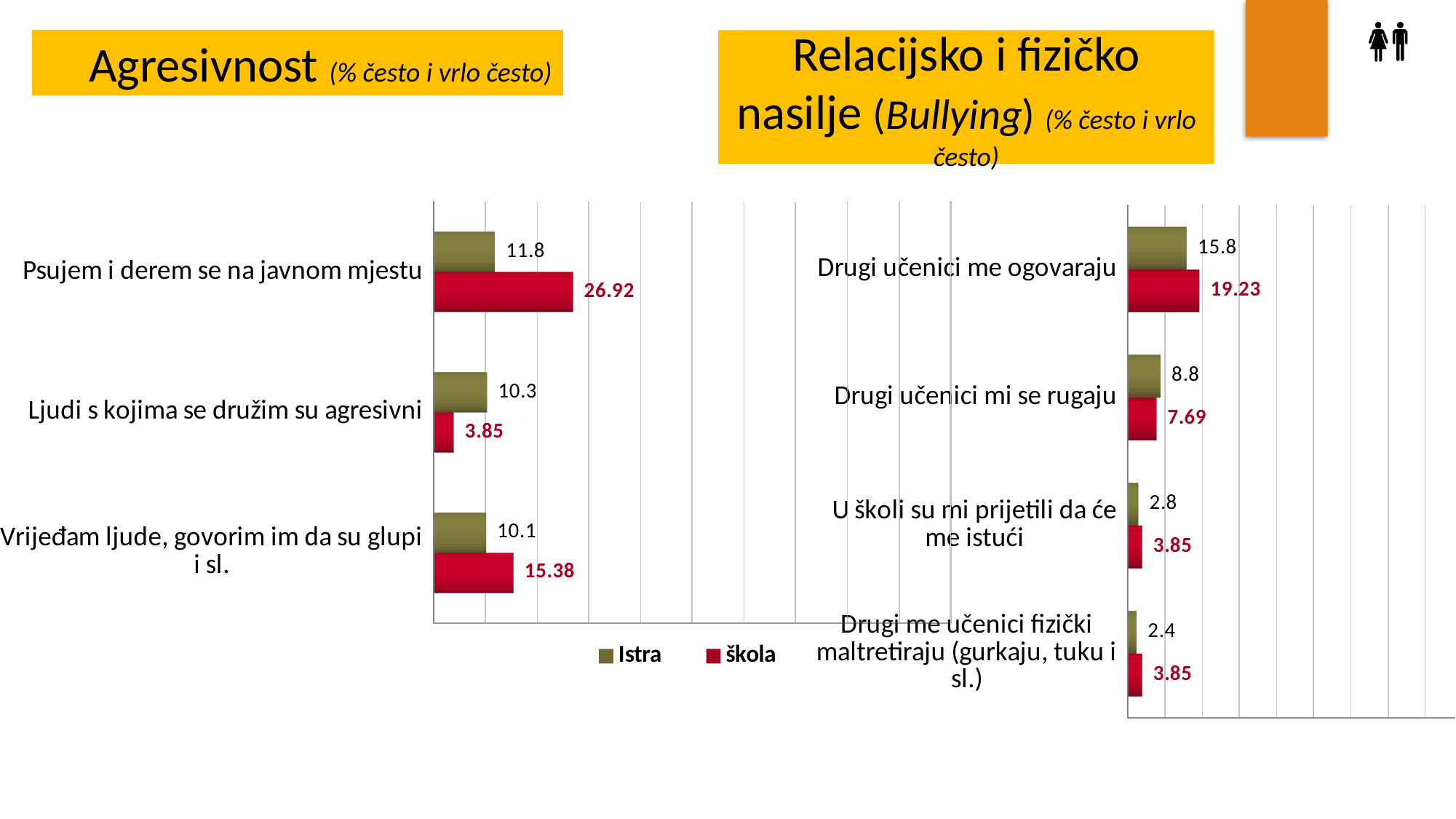
In the Relacijsko i fizičko nasilje (Bullying) chart, what is the škola value for 'Drugi učenici me ogovaraju'? 19.23 In the Agresivnost chart, which category has the highest škola value? Psujem i derem se na javnom mjestu In the Relacijsko i fizičko nasilje (Bullying) chart, what is the difference between the škola and Istra values for 'U školi su mi prijetili da će me istući'? 1.05 In the Relacijsko i fizičko nasilje (Bullying) chart, which category has the lowest Istra value? Drugi me učenici fizički maltretiraju (gurkaju, tuku i sl.) In the Agresivnost chart, what is the difference between the škola and Istra values for 'Vrijeđam ljude, govorim im da su glupi i sl.'? 5.28 In the Relacijsko i fizičko nasilje (Bullying) chart, what is the Istra value for 'Drugi me učenici fizički maltretiraju (gurkaju, tuku i sl.)'? 2.4 In the Agresivnost chart, how many series does the legend list? 2 In the Relacijsko i fizičko nasilje (Bullying) chart, how many categories are shown? 4 What kind of chart is the Agresivnost chart? Bar chart In the Relacijsko i fizičko nasilje (Bullying) chart, is the Istra value or the škola value larger for 'Drugi učenici mi se rugaju'? Istra In the Agresivnost chart, what is the Istra value for 'Ljudi s kojima se družim su agresivni'? 10.3 In the Agresivnost chart, what is the škola value for 'Psujem i derem se na javnom mjestu'? 26.92